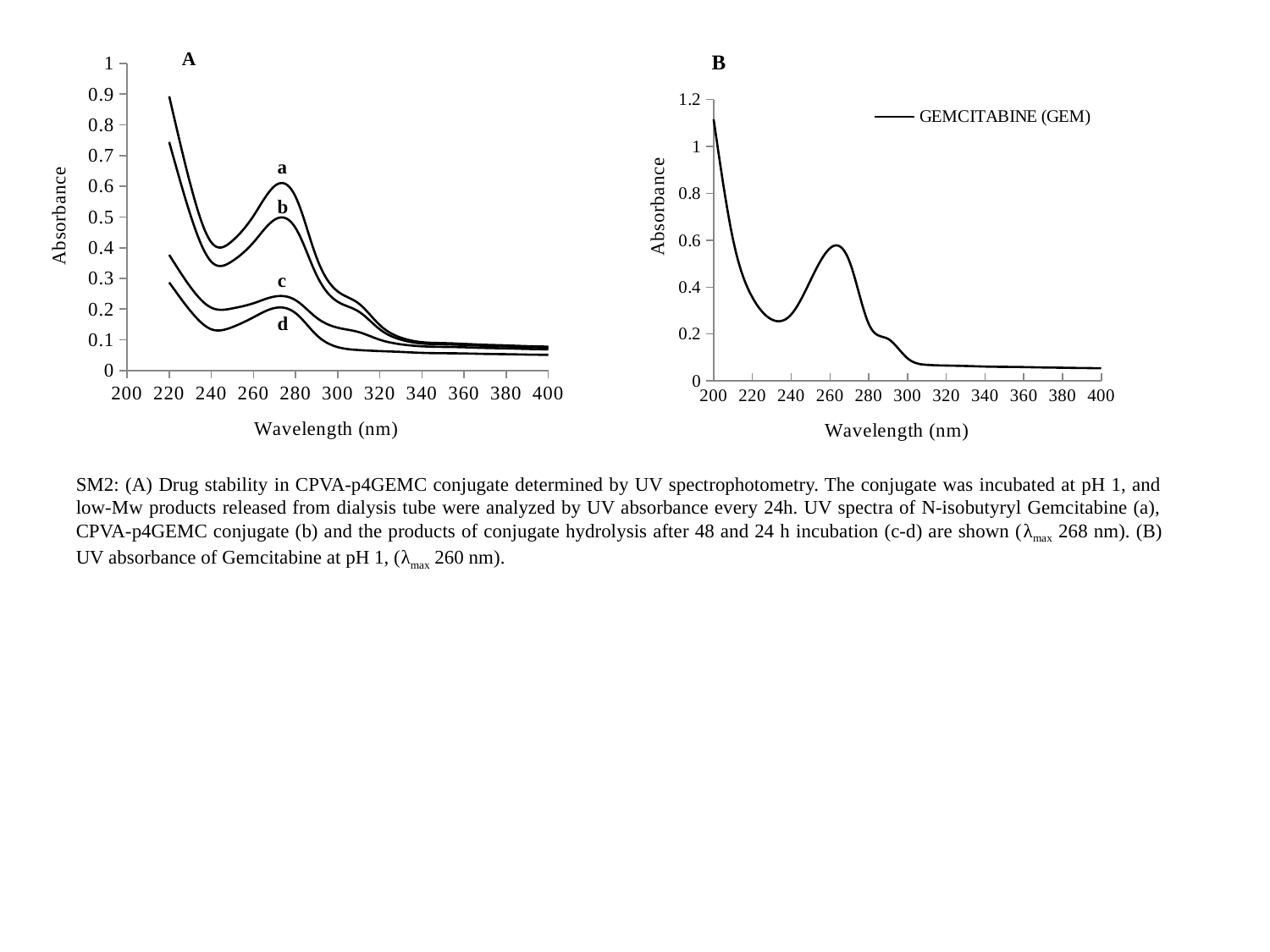
In chart A (the left chart), which curve has the lowest absorbance at 280 nm? d In chart B (the right chart), is the absorbance at 400 nm greater or less than 0.2? less How many curves are plotted in chart A (the left chart)? 4 What kind of chart is chart A (the left chart)? line chart In chart A (the left chart), is the peak absorbance of curve a greater or less than 0.5? greater In chart B (the right chart), does the absorbance rise or fall between 240 nm and 260 nm? rise In chart B (the right chart), what is the legend entry for the plotted series? GEMCITABINE (GEM) What is the x-axis label of chart A (the left chart)? Wavelength (nm) In chart A (the left chart), which curve has the highest absorbance at 280 nm? a In chart B (the right chart), is the absorbance at 200 nm greater or less than 1? greater How many series does the legend in chart B (the right chart) list? 1